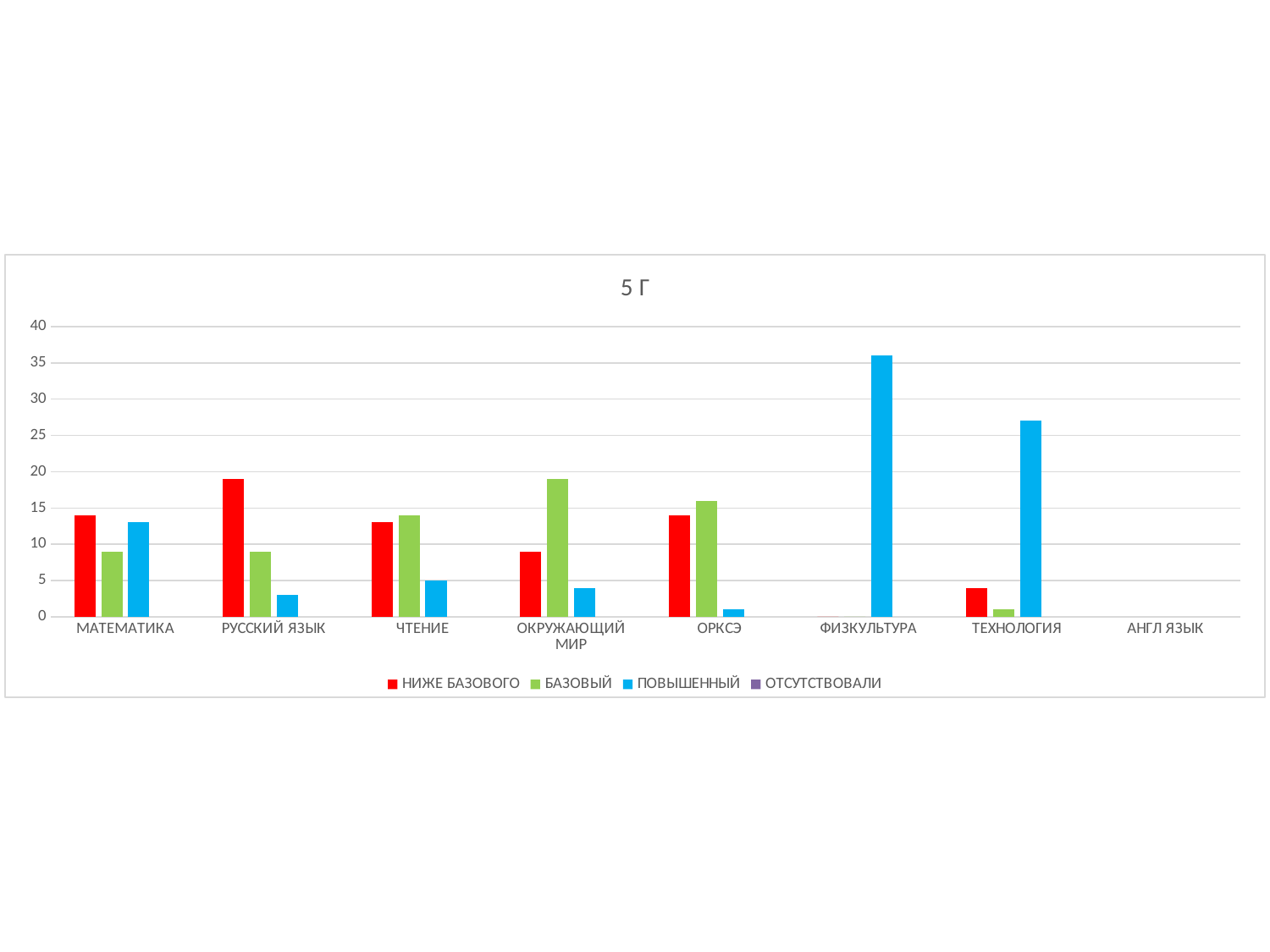
For ОКРУЖАЮЩИЙ МИР, which is larger: БАЗОВЫЙ or НИЖЕ БАЗОВОГО? БАЗОВЫЙ Is the ПОВЫШЕННЫЙ value for ОРКСЭ greater or less than 5? less Which category has the highest ПОВЫШЕННЫЙ value? ФИЗКУЛЬТУРА For МАТЕМАТИКА, which is larger: НИЖЕ БАЗОВОГО or БАЗОВЫЙ? НИЖЕ БАЗОВОГО How many categories are shown on the x axis? 8 How many series does the legend list? 4 What kind of chart is shown on the slide? bar chart Is the ПОВЫШЕННЫЙ value for ФИЗКУЛЬТУРА greater or less than 30? greater Which category has the highest НИЖЕ БАЗОВОГО value? РУССКИЙ ЯЗЫК Is the ПОВЫШЕННЫЙ value for ТЕХНОЛОГИЯ greater or less than 25? greater Which category has the highest БАЗОВЫЙ value? ОКРУЖАЮЩИЙ МИР What is the title of the chart? 5 Г